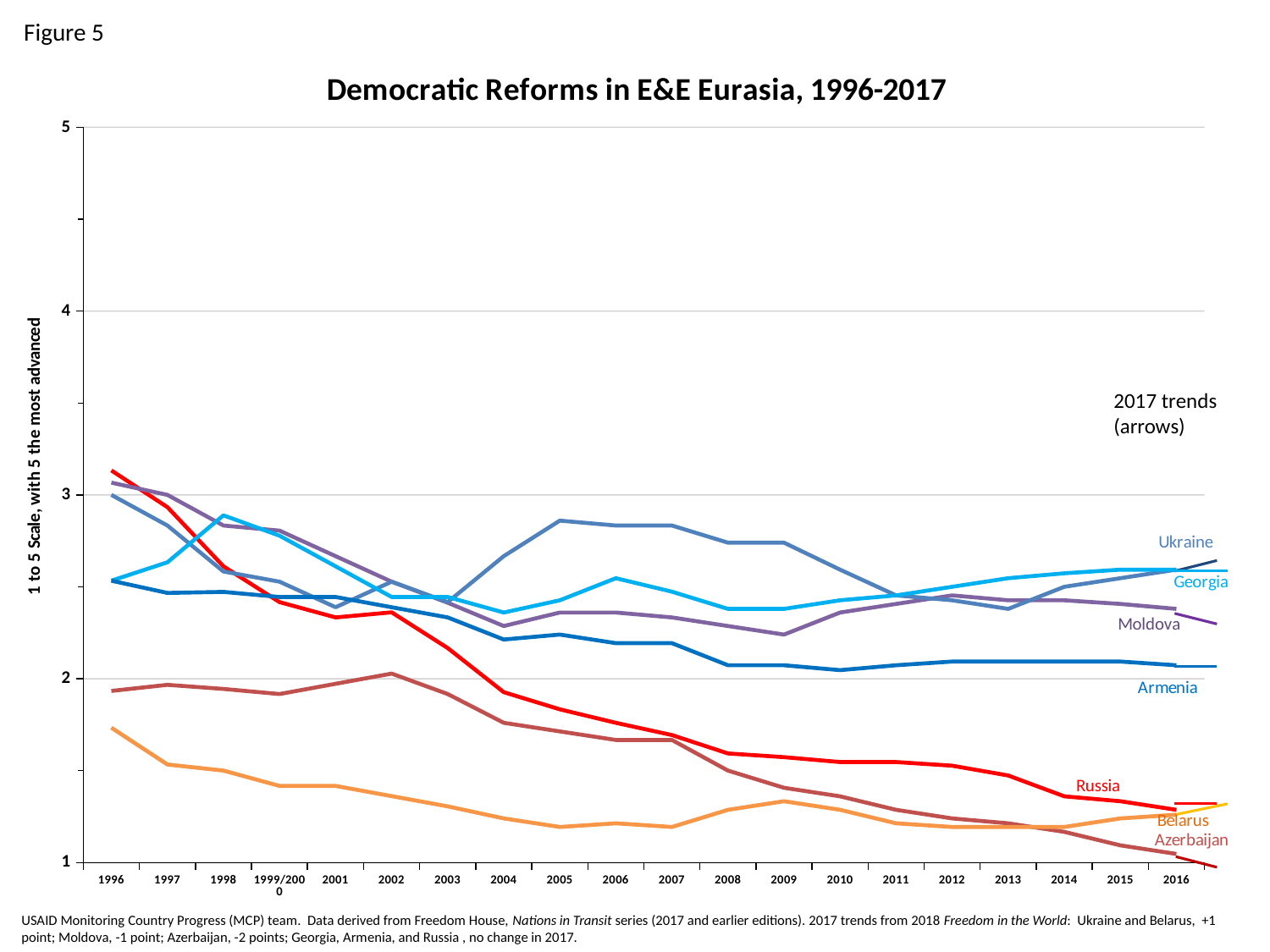
Is the value for Ukraine in 2005 greater or less than 2.5? greater Does the value for Russia rise or fall from 1996 to 2016? fall Which country has the lowest value in 1996? Belarus Is the value for Russia in 1996 greater or less than 3? greater Is the value for Russia in 2016 greater or less than 2? less What kind of chart is shown on the slide? line chart In 2016, which is larger, the value for Ukraine or the value for Armenia? Ukraine How many countries are plotted as lines on the chart? 7 How many year labels are shown along the x axis? 20 What is the title of the chart? Democratic Reforms in E&E Eurasia, 1996-2017 What is the label on the y axis? 1 to 5 Scale, with 5 the most advanced Which country has the lowest value in 2016? Azerbaijan